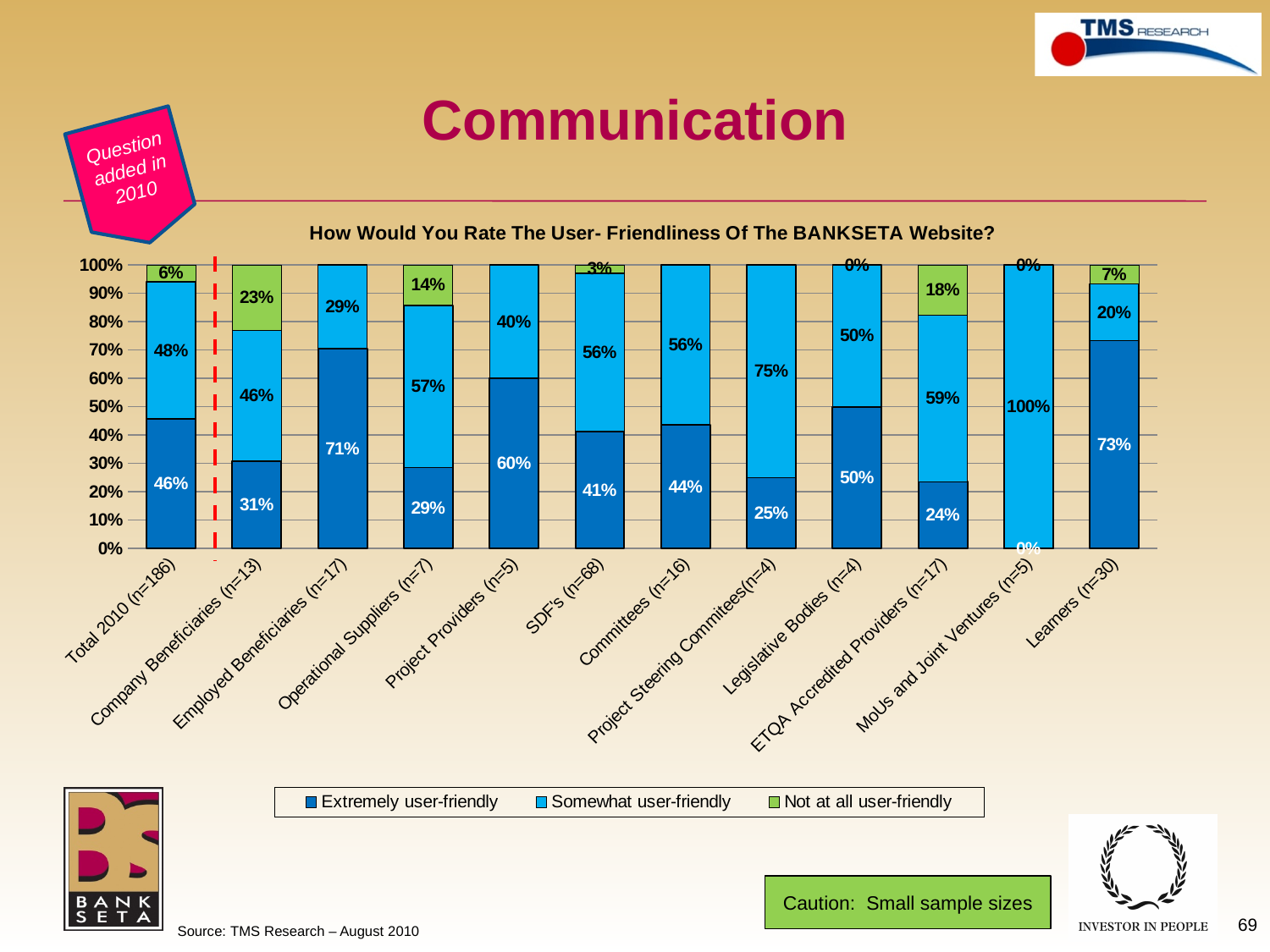
How many respondent categories are shown on the x axis? 12 What percentage of Company Beneficiaries (n=13) rated the website Not at all user-friendly? 23% What is the Not at all user-friendly value for ETQA Accredited Providers (n=17)? 18% For Total 2010 (n=186), what is the difference between the Somewhat user-friendly and Extremely user-friendly percentages? 2 percentage points What is the Somewhat user-friendly value for Project Steering Committees (n=4)? 75% Which has a higher Extremely user-friendly percentage: Operational Suppliers (n=7) or Project Providers (n=5)? Project Providers (n=5) What percentage of Learners (n=30) rated the BANKSETA website as Extremely user-friendly? 73% How many series does the legend list? 3 Which category has the highest Not at all user-friendly percentage? Company Beneficiaries (n=13) What type of chart is shown on the slide? Stacked bar chart Which category has the lowest Extremely user-friendly percentage? MoUs and Joint Ventures (n=5) What is the Somewhat user-friendly value for MoUs and Joint Ventures (n=5)? 100%